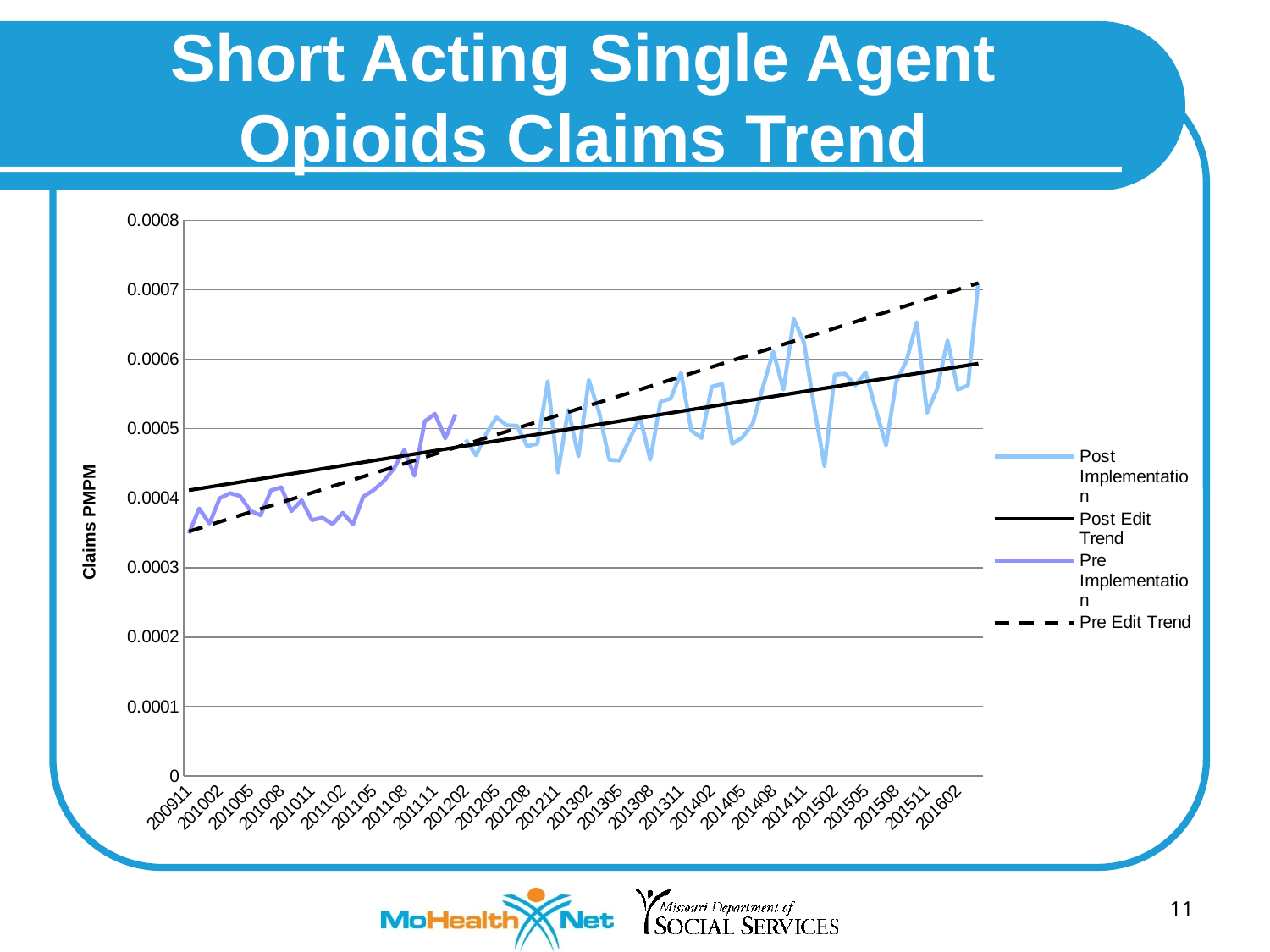
How many series does the legend list? 4 Is the Pre Edit Trend value at 201602 greater or less than 0.0006? greater Does the Post Edit Trend line rise or fall from left to right along the x axis? rise What is the label on the vertical axis? Claims PMPM Which series is drawn as a dashed line? Pre Edit Trend How many period labels are shown on the x axis? 26 Is the Pre Implementation value at 200911 greater or less than 0.0004? less Is the Post Implementation value at 201411 greater or less than 0.0006? greater At 201602, which is higher: the Pre Edit Trend line or the Post Edit Trend line? Pre Edit Trend What kind of chart is shown on the slide? line chart Does the Pre Edit Trend line rise or fall from left to right along the x axis? rise